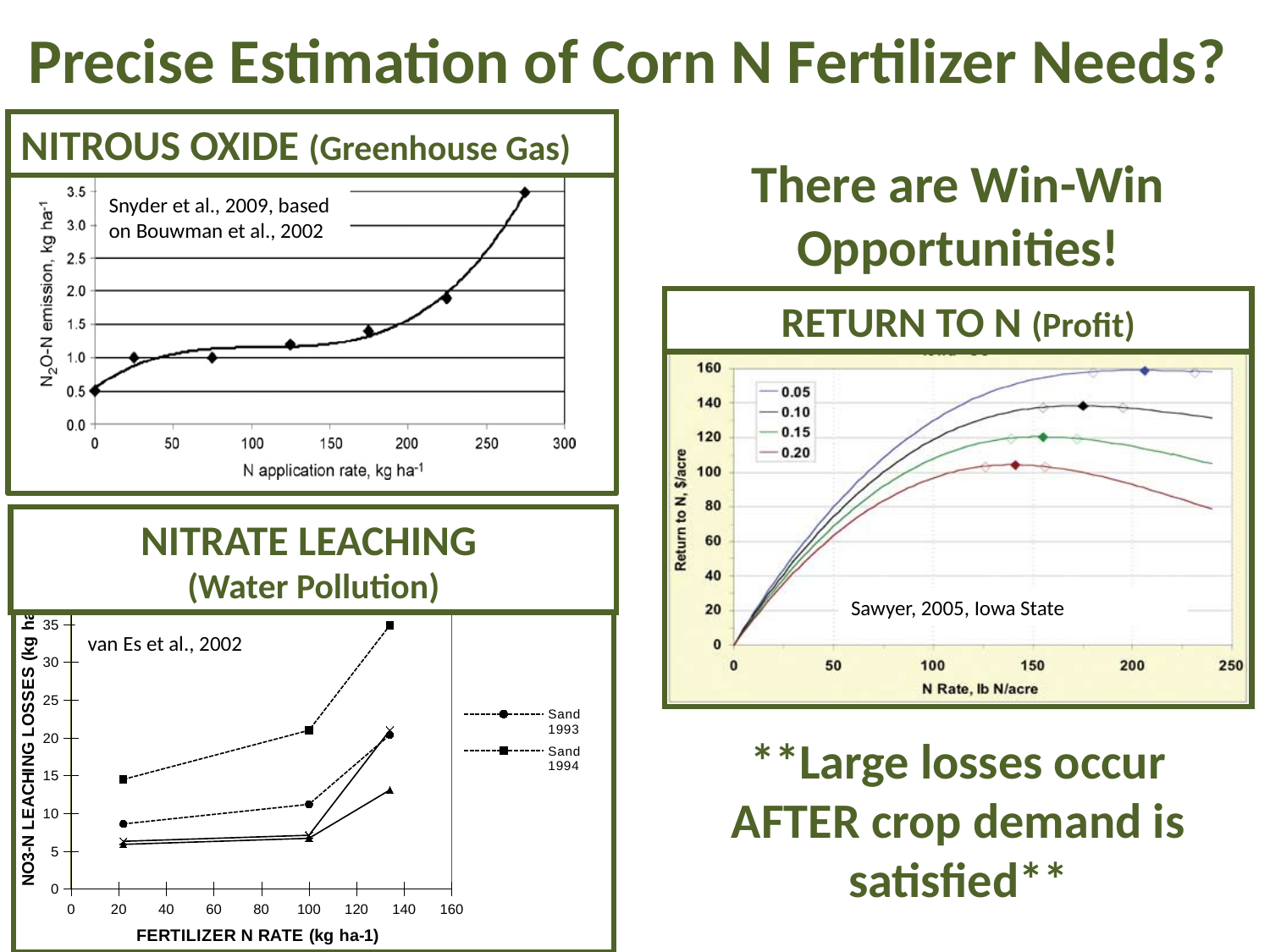
How many series does the legend of the RETURN TO N chart list? 4 In the NITRATE LEACHING chart, do NO3-N leaching losses rise or fall as the fertilizer N rate increases? rise What kind of chart is the NITROUS OXIDE chart? line chart In the NITROUS OXIDE chart, do N2O-N emissions rise or fall as the N application rate increases? rise In the NITRATE LEACHING chart, is the Sand 1994 value at the highest fertilizer N rate greater or less than 30? greater In the NITRATE LEACHING chart, which series has the higher NO3-N leaching loss at the highest fertilizer N rate, Sand 1993 or Sand 1994? Sand 1994 In the NITROUS OXIDE chart, is the N2O-N emission at an N application rate of 275 kg/ha greater or less than 3.0? greater How many data points are plotted in the NITROUS OXIDE chart? 7 In the NITROUS OXIDE chart, is the N2O-N emission at an N application rate of 0 kg/ha greater or less than 1.0? less In the RETURN TO N chart, which series reaches the highest return to N? 0.05